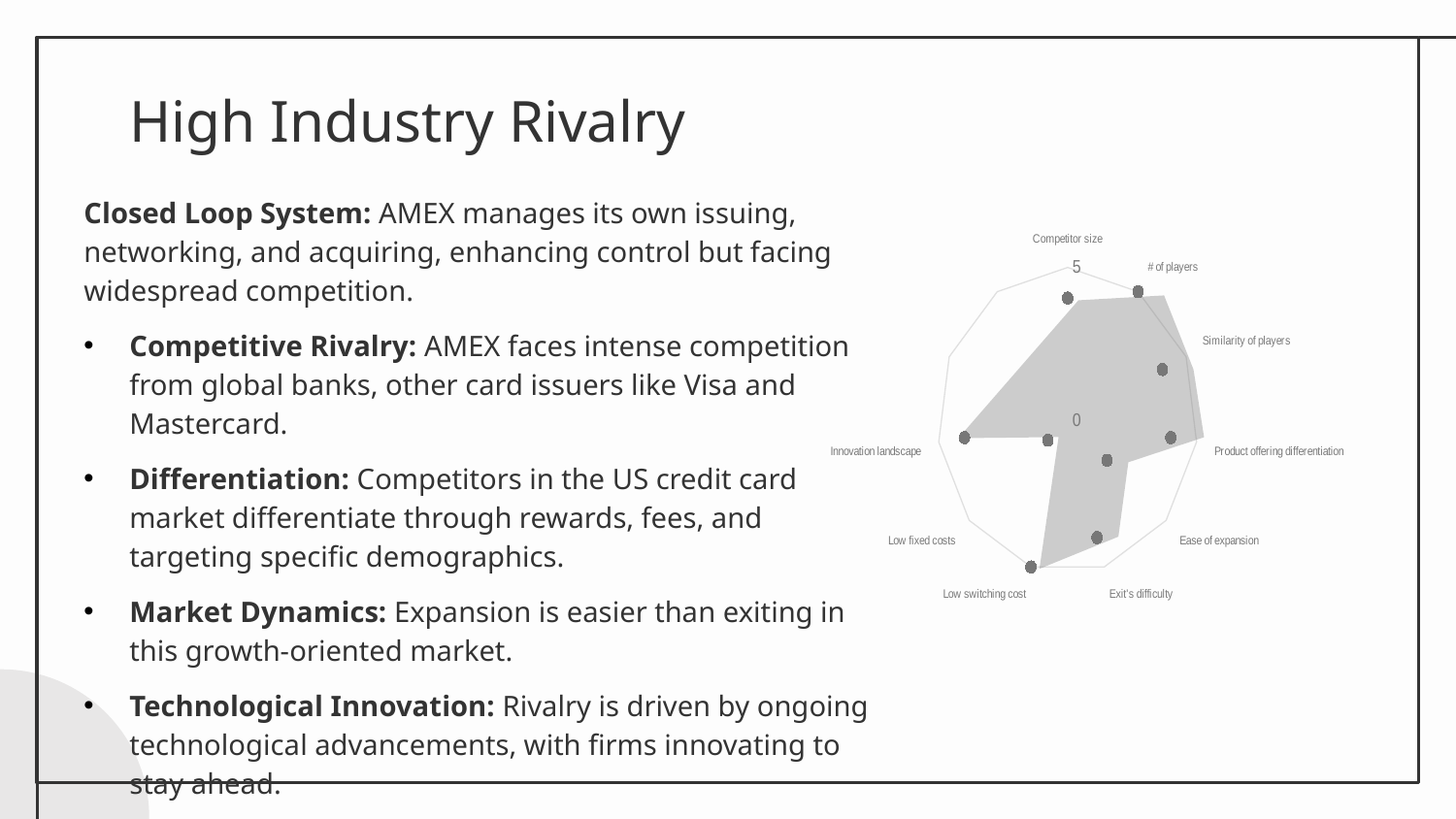
How many categories (axes) does the radar chart have? 9 Which has the larger value, Ease of expansion or Low fixed costs? Ease of expansion Which has the larger value, Similarity of players or Ease of expansion? Similarity of players Is the value for Low fixed costs greater or less than 5? less Which has the larger value, Competitor size or Low fixed costs? Competitor size What kind of chart is shown on the slide? radar chart Is the value for Ease of expansion greater or less than 5? less Which category has the lowest value on the radar chart? Low fixed costs What is the maximum value shown on the radar chart's scale? 5 Is the value for Similarity of players greater or less than 5? less Which category is at the top of the radar chart? Competitor size